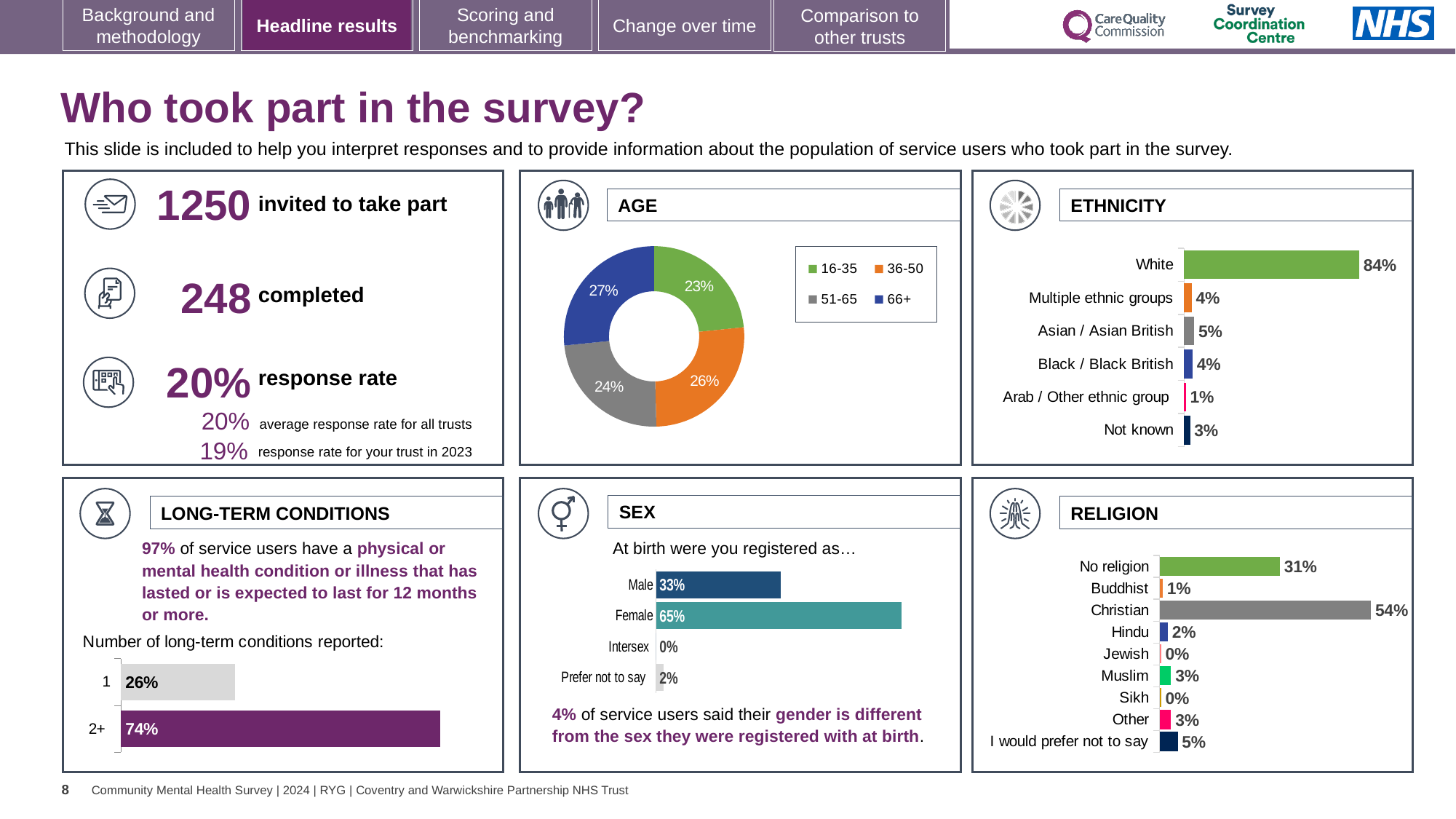
In the AGE chart, which age group has the smallest share? 16-35 In the ETHNICITY chart, what is the value for Asian / Asian British? 5% What kind of chart is the AGE chart? Doughnut chart In the SEX chart, which is larger, Male or Female? Female In the LONG-TERM CONDITIONS chart, what is the difference between the 2+ and 1 categories? 48% How many entries does the legend of the AGE chart list? 4 In the ETHNICITY chart, what is the difference between White and Not known? 81% In the SEX chart, what is the value for Female? 65% In the ETHNICITY chart, which category has the highest value? White How many categories are shown in the ETHNICITY chart? 6 In the RELIGION chart, what is the value for Christian? 54% In the AGE chart, what percentage of respondents were aged 66+? 27%